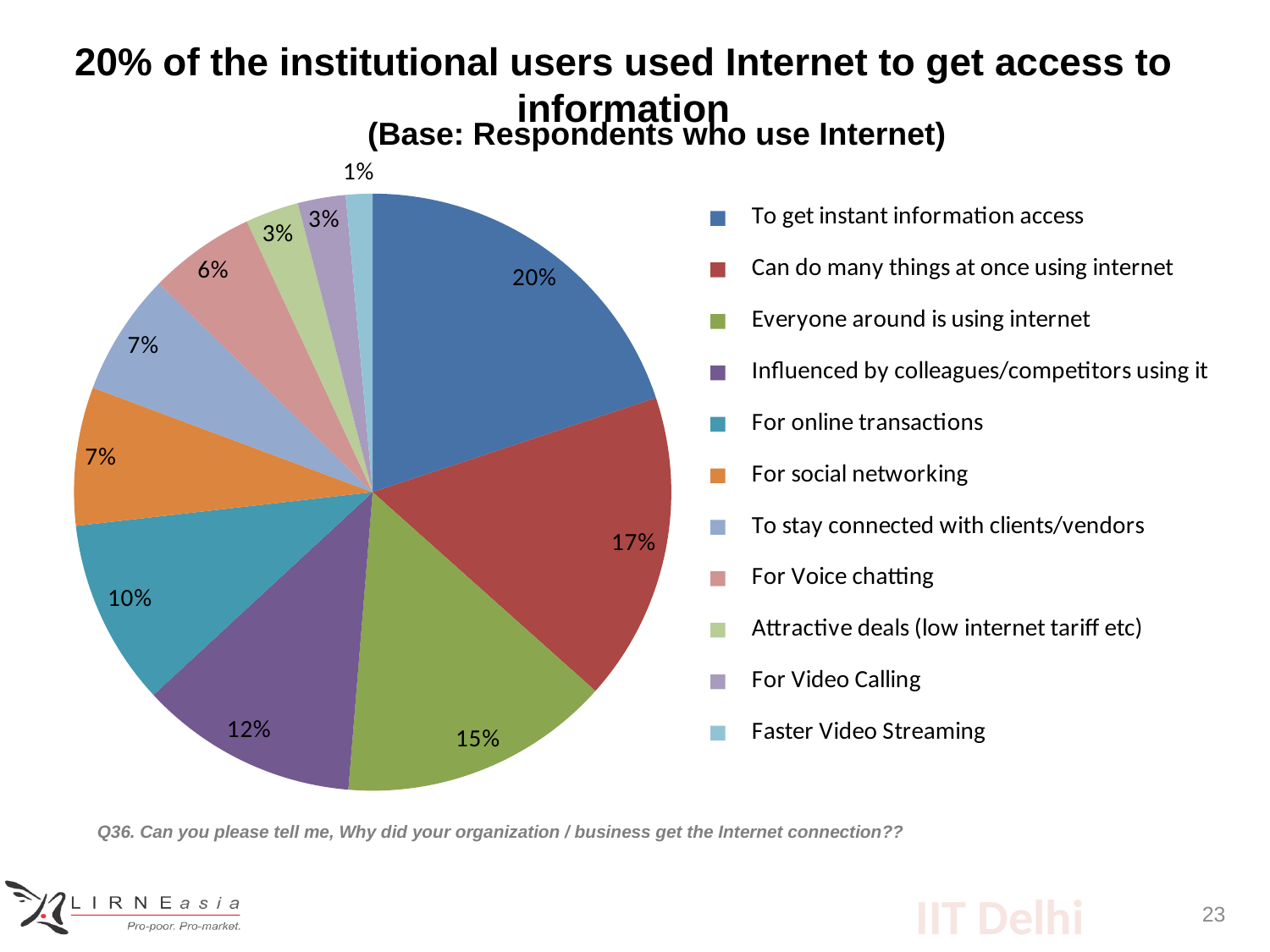
Which category has the largest slice of the pie? To get instant information access What is the difference in percentage points between "Everyone around is using internet" and "For Voice chatting"? 9 What share of the pie is labelled for "To get instant information access"? 20% What is the combined share of "Attractive deals (low internet tariff etc)" and "For Video Calling"? 6% What type of chart is shown on the slide? Pie chart What base is stated in the chart subtitle? Respondents who use Internet What percentage is shown for "Influenced by colleagues/competitors using it"? 12% What percentage is shown for "Can do many things at once using internet"? 17% How many categories does the legend list? 11 What percentage is shown for "For online transactions"? 10% Which category has the smallest slice of the pie? Faster Video Streaming Which is larger: the slice for "For online transactions" or the slice for "For social networking"? For online transactions